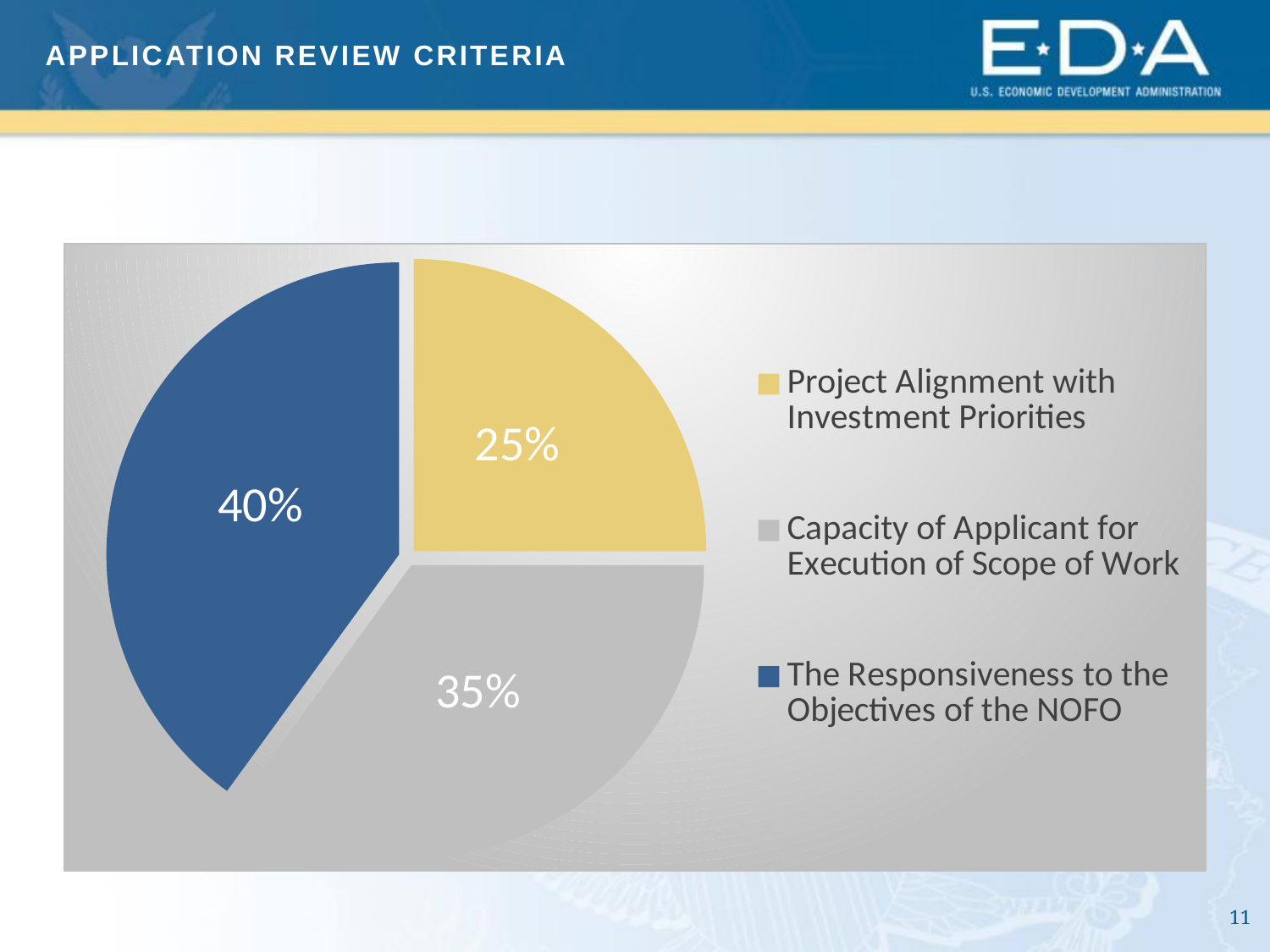
What share of the pie is Project Alignment with Investment Priorities? 25% What is the difference in percentage points between Capacity of Applicant for Execution of Scope of Work and Project Alignment with Investment Priorities? 10% What share of the pie is The Responsiveness to the Objectives of the NOFO? 40% What colour is the slice for The Responsiveness to the Objectives of the NOFO? Blue What is the difference in percentage points between The Responsiveness to the Objectives of the NOFO and Project Alignment with Investment Priorities? 15% Which criterion has the largest slice of the pie? The Responsiveness to the Objectives of the NOFO What share of the pie is Capacity of Applicant for Execution of Scope of Work? 35% How many entries does the legend list? 3 Which is larger: the slice for Capacity of Applicant for Execution of Scope of Work or the slice for Project Alignment with Investment Priorities? Capacity of Applicant for Execution of Scope of Work How many slices does the pie chart have? 3 Which criterion has the smallest slice of the pie? Project Alignment with Investment Priorities What kind of chart is shown on the slide? Pie chart